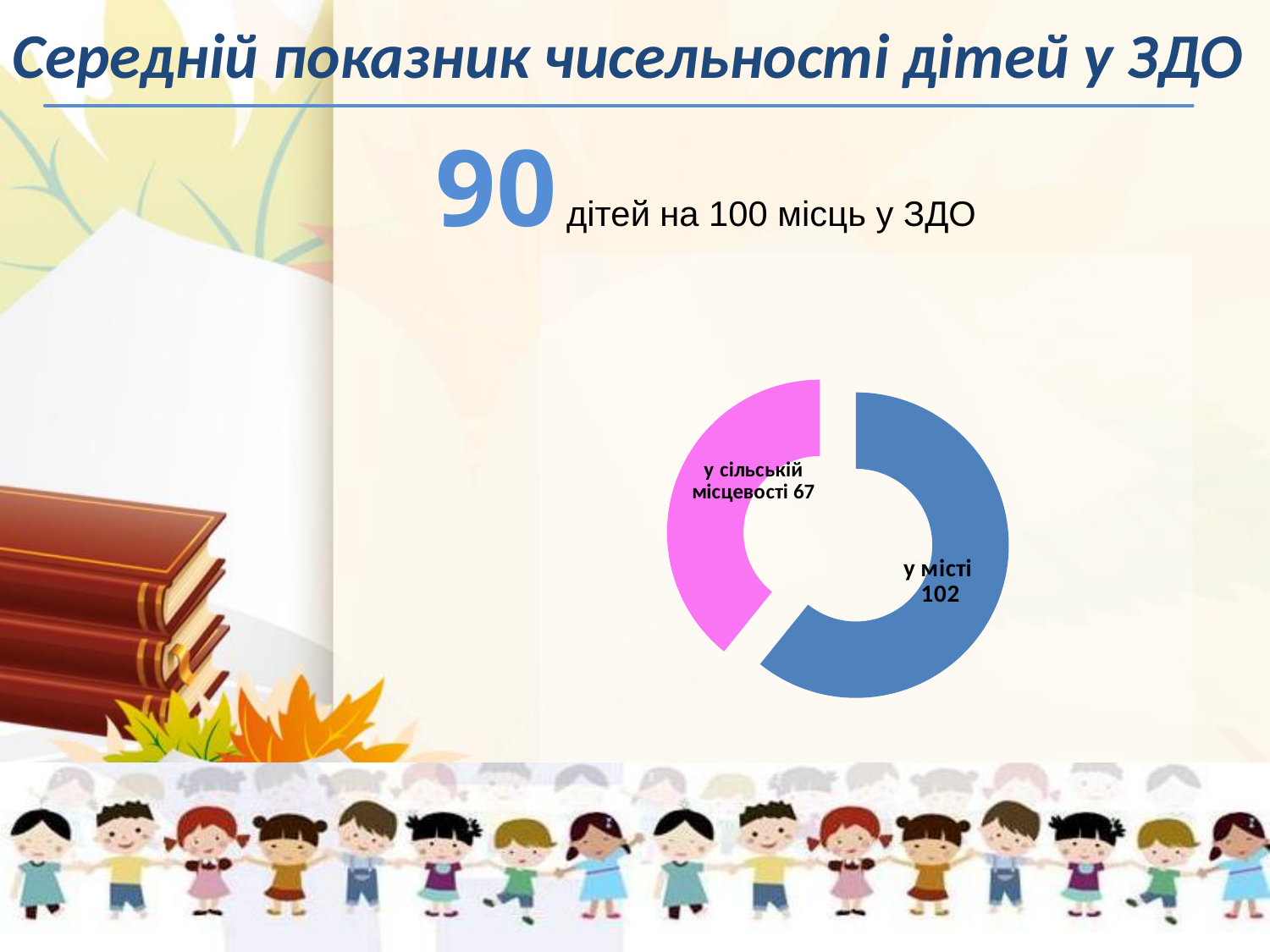
What colour is the "у місті" segment of the chart? blue What is the difference between the values for "у місті" and "у сільській місцевості"? 35 What is the value for "у місті" in the doughnut chart? 102 Which is larger: the value for "у місті" or for "у сільській місцевості"? у місті What is the title of the slide containing the chart? Середній показник чисельності дітей у ЗДО Which category has the lowest value in the doughnut chart? у сільській місцевості Which category has the highest value in the doughnut chart? у місті How many categories are shown in the doughnut chart? 2 What is the value for "у сільській місцевості" in the doughnut chart? 67 What kind of chart is shown on the slide? doughnut (pie) chart